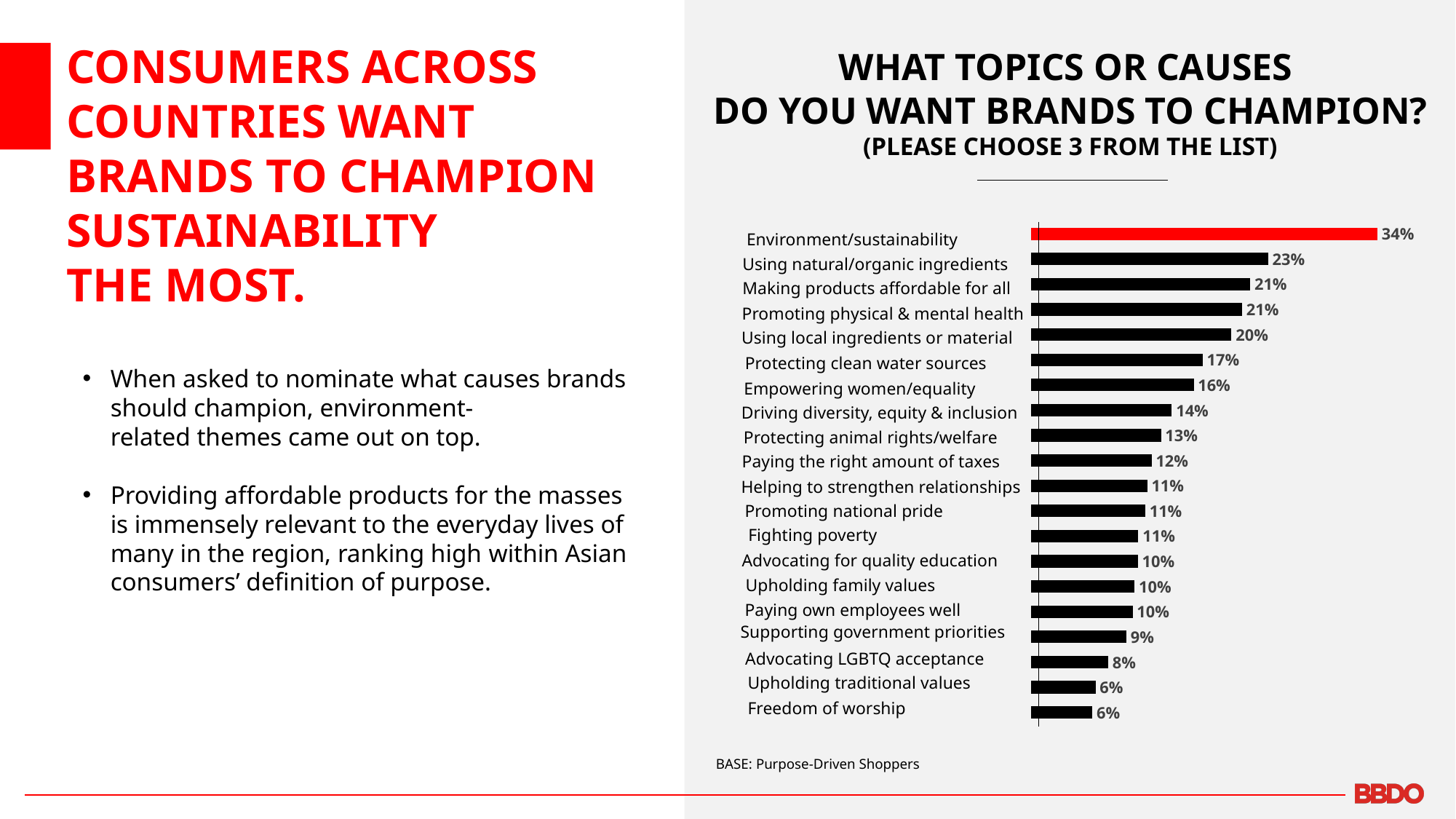
What is the value for Advocating LGBTQ acceptance? 8% What percentage of respondents want brands to champion Environment/sustainability? 34% Which topic or cause has the highest percentage in the chart? Environment/sustainability How many topics or causes are listed in the chart? 20 What type of chart is shown on the slide? Bar chart Which bar in the chart is coloured red rather than black? Environment/sustainability What is the difference between the values for Environment/sustainability and Using natural/organic ingredients? 11% What is the lowest percentage value shown in the chart? 6% What is the value for Using natural/organic ingredients? 23% Which has a higher value: Using local ingredients or material or Protecting animal rights/welfare? Using local ingredients or material What is the difference between Empowering women/equality and Driving diversity, equity & inclusion? 2% What percentage is shown for Protecting clean water sources? 17%